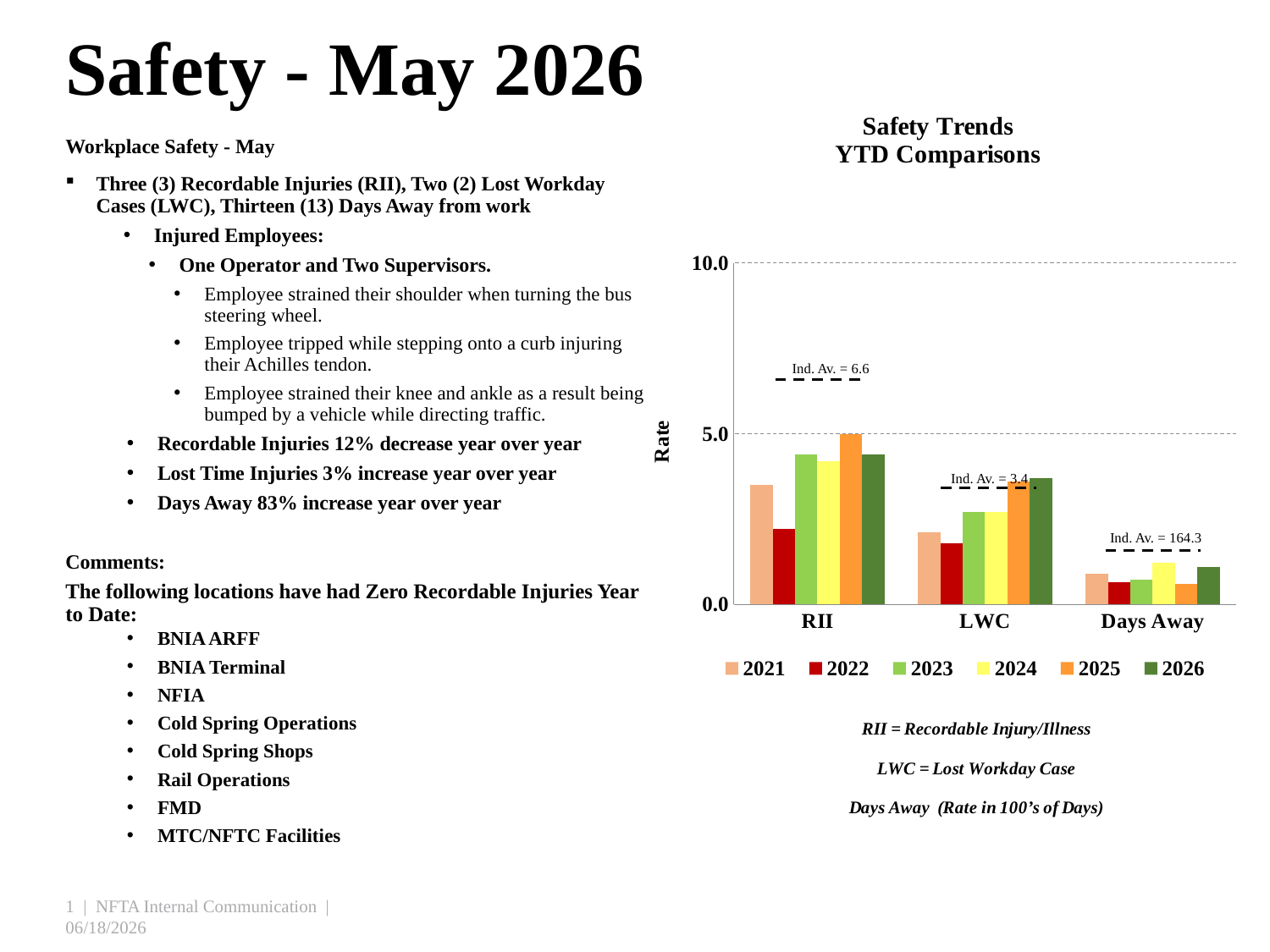
In the Safety Trends chart, which is larger for RII: the 2022 rate or the 2023 rate? 2023 In the Safety Trends chart, which year has the lowest LWC rate? 2022 What is the label of the y axis in the Safety Trends chart? Rate In the Safety Trends chart, is the RII rate for 2021 greater or less than 5.0? less In the Safety Trends chart, which is larger for LWC: the 2021 rate or the 2025 rate? 2025 What kind of chart is shown under the title "Safety Trends YTD Comparisons"? Bar chart How many categories are shown on the x axis of the Safety Trends chart? 3 How many series does the legend of the Safety Trends chart list? 6 In the Safety Trends chart, which year has the highest RII rate? 2025 In the Safety Trends chart, is the LWC rate for 2026 greater or less than 5.0? less What industry average value is annotated above the RII bars in the Safety Trends chart? Ind. Av. = 6.6 In the Safety Trends chart, which year has the lowest RII rate? 2022